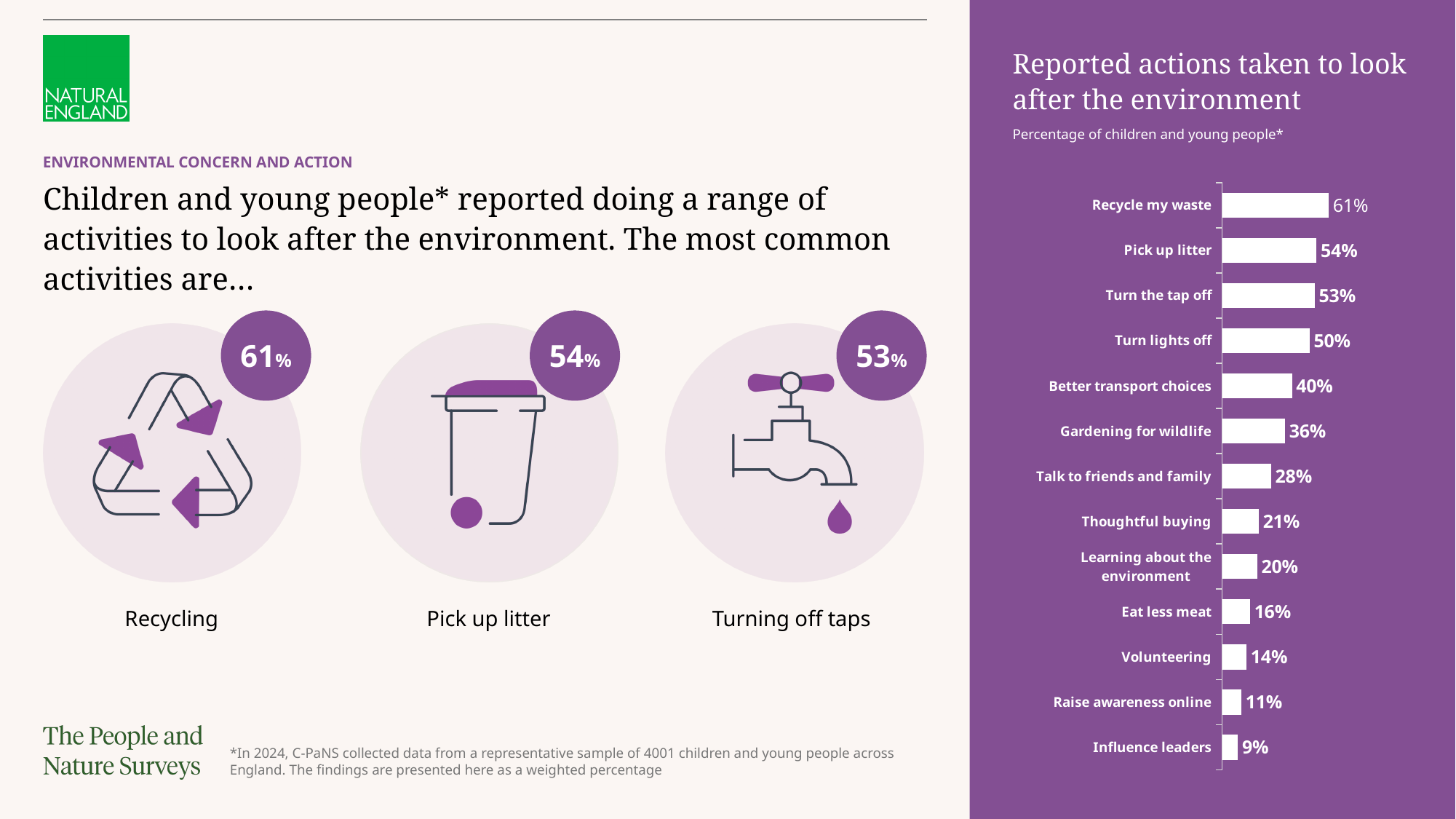
Which reported action has the highest percentage? Recycle my waste What kind of chart is used to show the reported actions? Bar chart What percentage of children and young people reported that they recycle their waste? 61% What percentage reported 'Raise awareness online'? 11% Which is larger: the value for 'Eat less meat' or the value for 'Volunteering'? Eat less meat Which reported action has the lowest percentage? Influence leaders What percentage reported 'Gardening for wildlife'? 36% What is the difference between the percentages for 'Pick up litter' and 'Turn lights off'? 4% What is the value for 'Better transport choices' in the chart? 40% What is the title of the chart on the right of the slide? Reported actions taken to look after the environment What is the difference between 'Talk to friends and family' and 'Thoughtful buying'? 7% How many reported actions are listed in the chart? 13